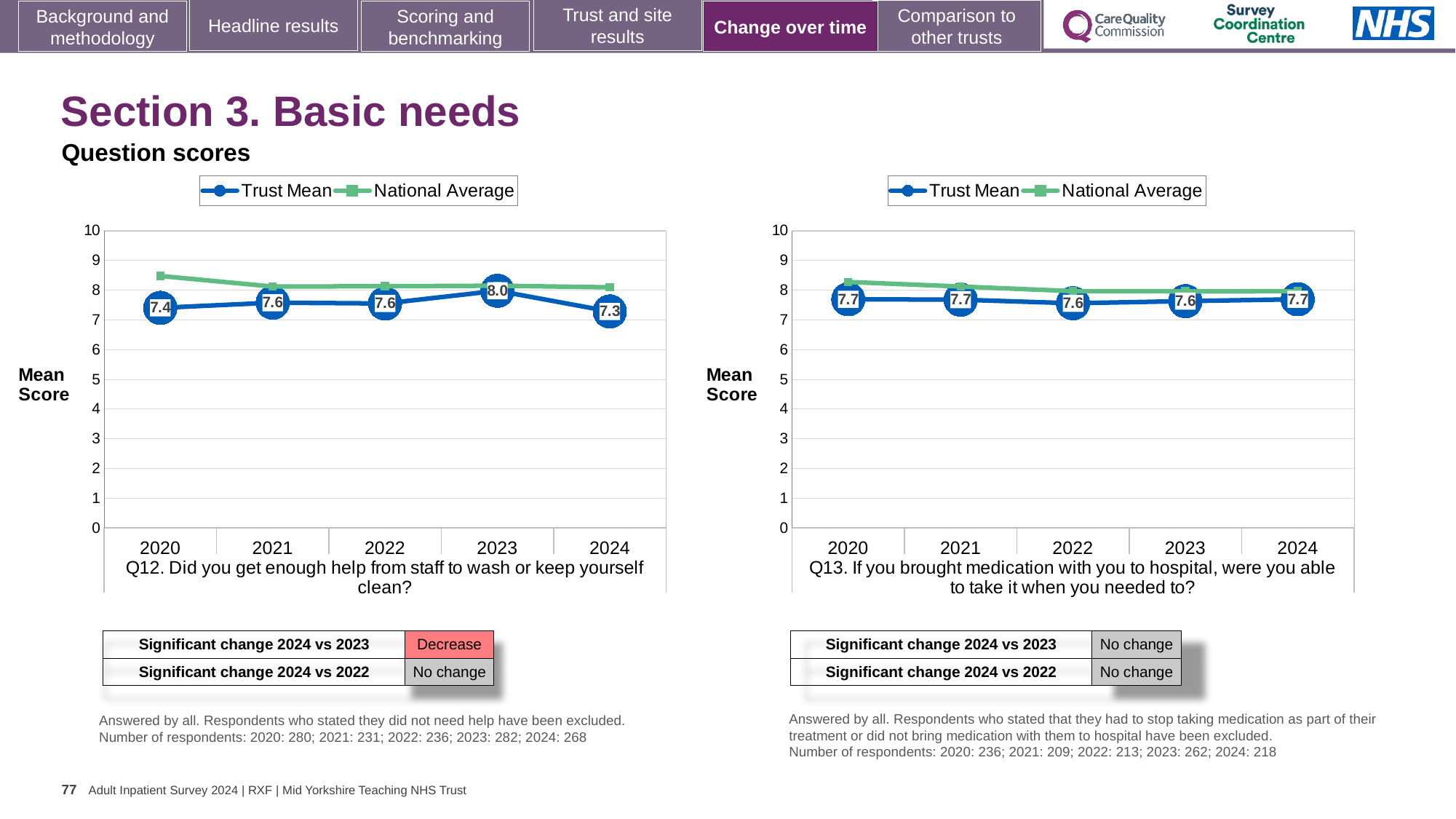
In the Q12 chart (left), which year has the highest Trust Mean score? 2023 In the Q12 chart (left), what is the difference between the Trust Mean scores for 2023 and 2024? 0.7 How many years are plotted on the x axis of the Q13 chart (right)? 5 What type of chart is used for Q13 (right)? Line chart How many series does the legend of the Q12 chart (left) list? 2 In the Q12 chart (left), what is the Trust Mean score for 2024? 7.3 In the Q13 chart (right), what is the Trust Mean score for 2022? 7.6 In the Q12 chart (left), which year has the lowest Trust Mean score? 2024 In the Q12 chart (left), what is the Trust Mean score for 2023? 8.0 In the Q12 chart (left), is the National Average value for 2020 greater or less than 8? greater In the Q12 chart (left), what does the significant change table show for 2024 vs 2023? Decrease In the Q13 chart (right), is the Trust Mean score for 2020 larger or smaller than the score for 2022? larger